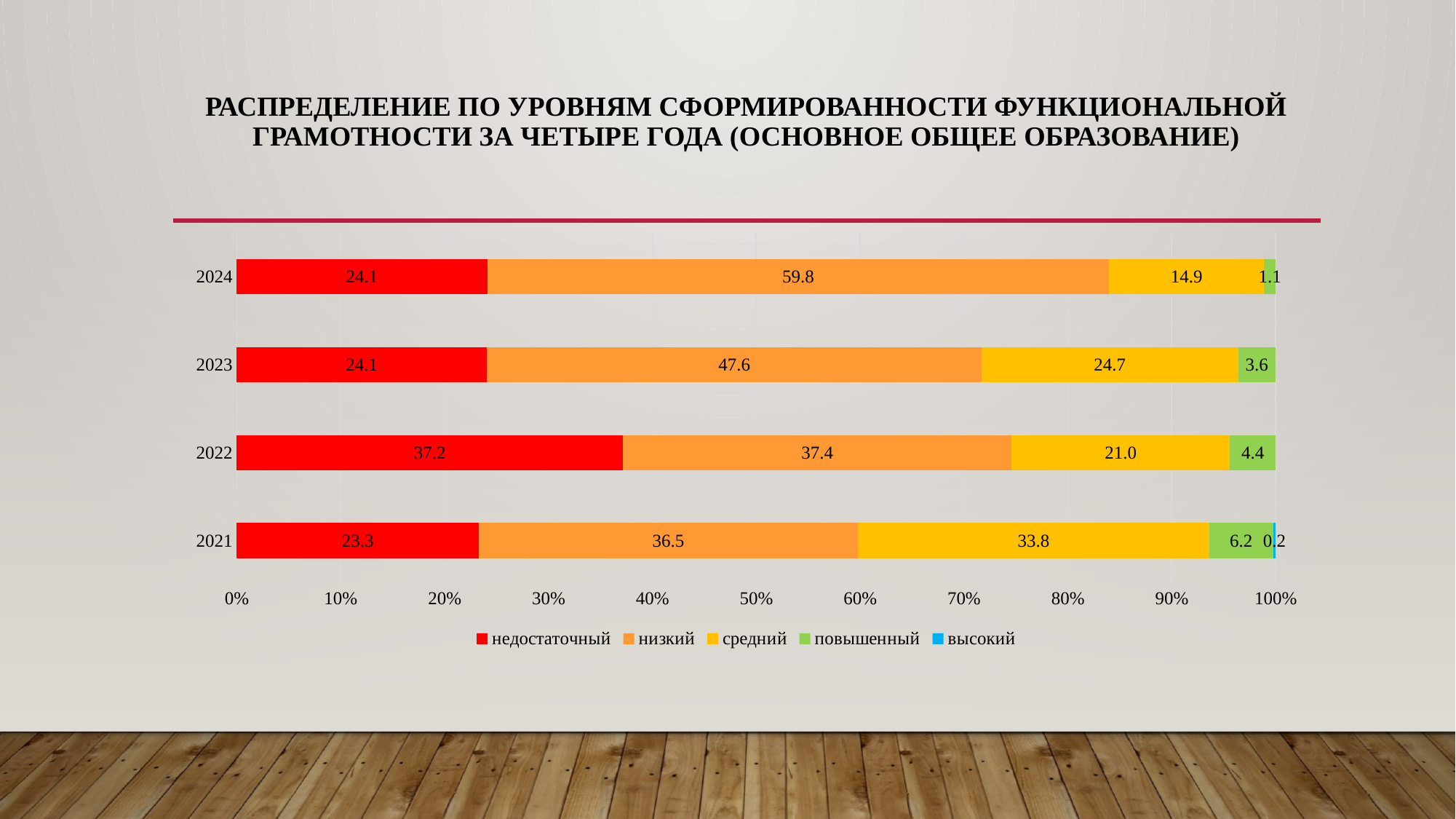
Which year has the lowest value for the повышенный level? 2024 Does the повышенный value rise or fall from 2021 to 2024? Fall How many series does the legend list? 5 What is the value of the средний segment for 2021? 33.8 How many years are shown on the chart? 4 What is the value of the повышенный segment for 2023? 3.6 Which year has the larger средний value, 2023 or 2024? 2023 What is the difference between the недостаточный values for 2022 and 2021? 13.9 What is the value of the недостаточный segment for 2022? 37.2 What is the value of the низкий segment for 2024? 59.8 Which year has the highest value for the низкий level? 2024 What kind of chart is shown on the slide? Stacked bar chart